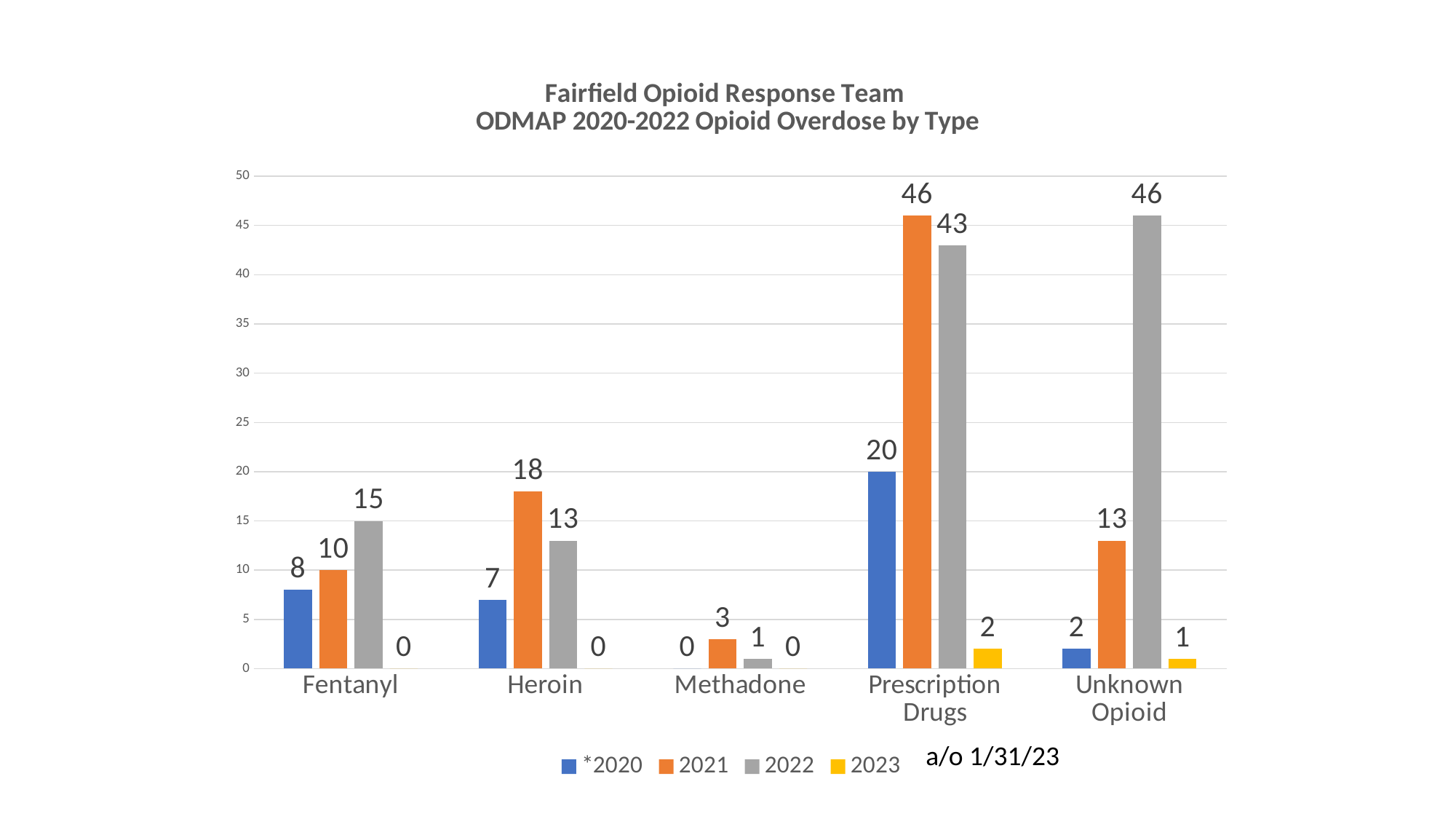
What is the difference between the 2021 and 2022 values for Prescription Drugs? 3 What is the value for Prescription Drugs in 2020? 20 What kind of chart is shown on the slide? Bar chart Which category has the lowest value in 2021? Methadone What is the value for Unknown Opioid in 2023? 1 Which category has the highest value in 2022? Unknown Opioid What is the value for Heroin in 2021? 18 How many series does the legend list? 4 What colour represents the 2023 series in the legend? Yellow Which is larger, the 2022 value for Heroin or the 2022 value for Fentanyl? Fentanyl What is the value for Fentanyl in 2022? 15 How many categories are shown on the x axis? 5